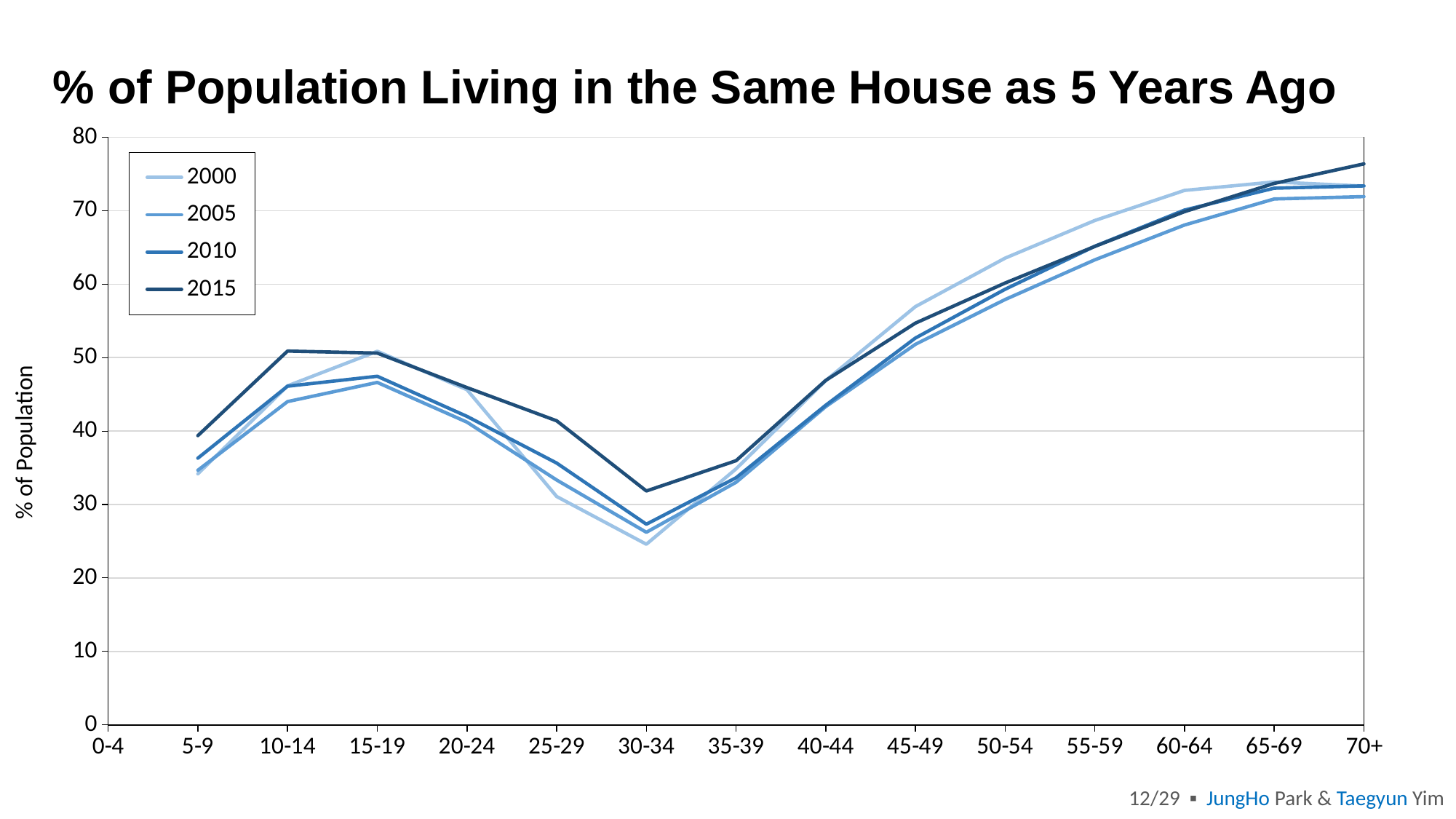
Is the value for the 2015 series at age group 30-34 greater or less than 30? greater Do the values for the 2015 series rise or fall from age group 30-34 to 70+? rise For the 2015 series, which age group has the highest value? 70+ For the 2000 series, which age group has the lowest value? 30-34 What kind of chart is shown on the slide? line chart What is the label on the y axis? % of Population For the 2015 series, which age group has the lowest value? 30-34 How many series does the legend list? 4 At age group 5-9, which series has the larger value, 2000 or 2015? 2015 Is the value for the 2000 series at age group 30-34 greater or less than 30? less What is the title of the chart? % of Population Living in the Same House as 5 Years Ago